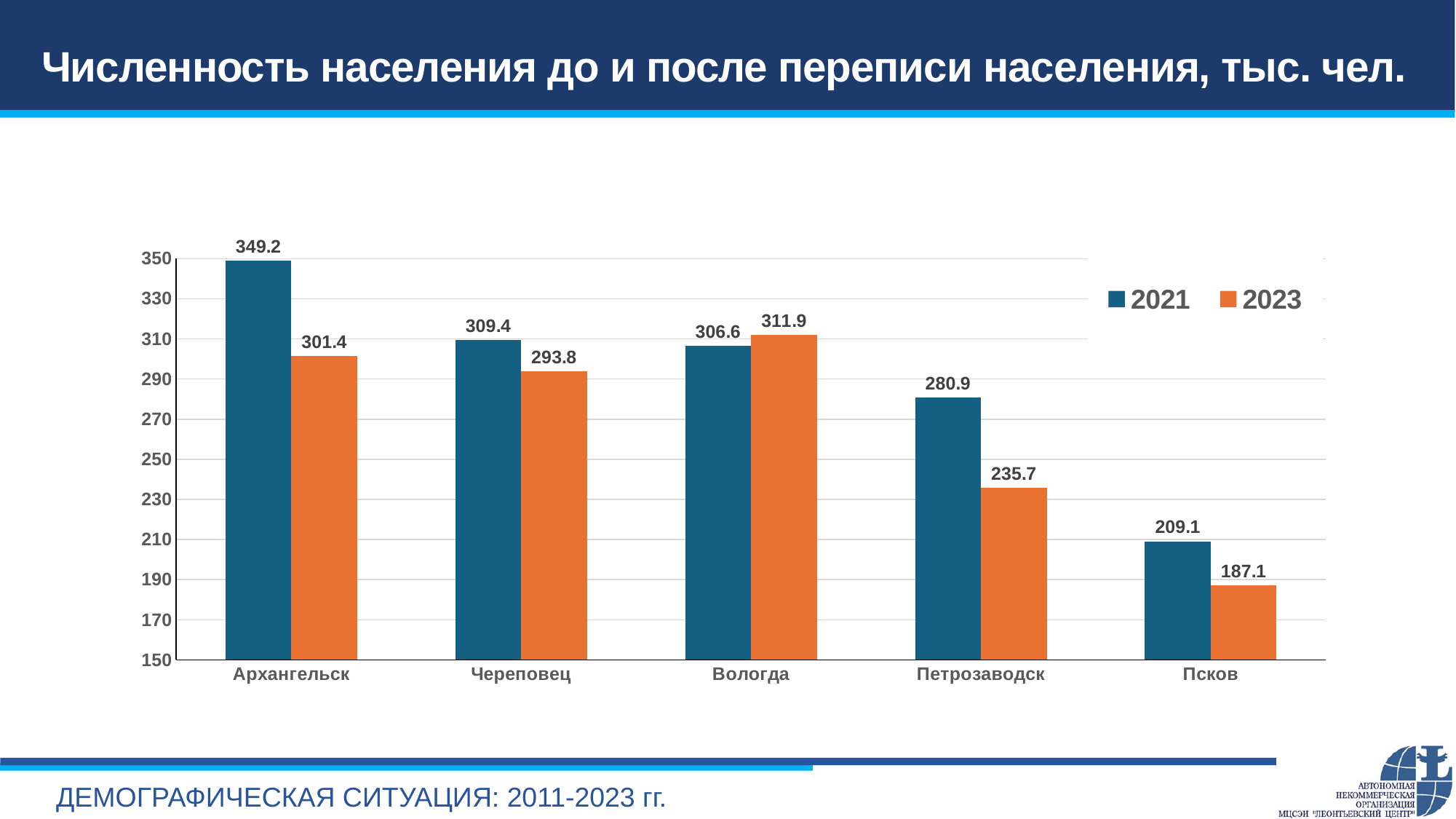
What kind of chart is shown on the slide? bar chart Which city has the highest 2021 value? Архангельск Is the 2023 value for Череповец greater or less than 290? greater What is the 2023 value for Псков? 187.1 What is the 2021 value for Архангельск? 349.2 Which colour represents the 2023 series in the legend? orange What is the difference between the 2021 and 2023 values for Петрозаводск? 45.2 How many cities are shown on the x axis? 5 What is the 2023 value for Вологда? 311.9 Which is larger for Вологда, the 2021 value or the 2023 value? 2023 Which city has the lowest 2023 value? Псков How many series does the legend list? 2